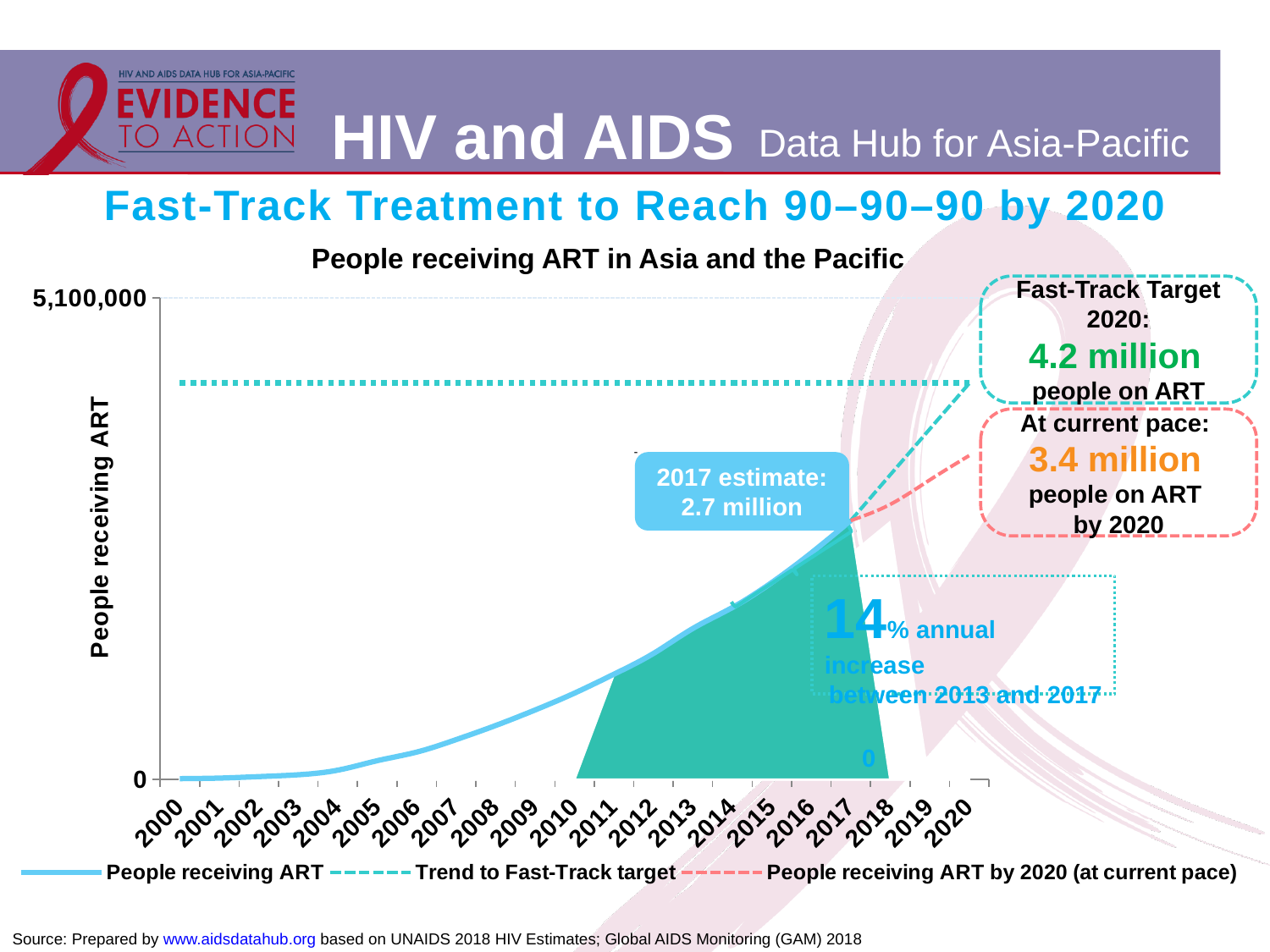
What is the difference between the Fast-Track Target for 2020 and the projected number on ART by 2020 at the current pace? 0.8 million What is the Fast-Track Target for 2020 for people on ART? 4.2 million What annual increase in people receiving ART is noted between 2013 and 2017? 14% What is the title of the chart? People receiving ART in Asia and the Pacific How many series does the legend list? 3 What kind of chart is used to show people receiving ART in Asia and the Pacific? Line chart Which is larger: the Fast-Track Target for 2020 or the projection at current pace for 2020? Fast-Track Target 2020 At the current pace, how many people are projected to be on ART by 2020? 3.4 million What is the 2017 estimate of people receiving ART shown on the chart? 2.7 million Does the number of people receiving ART rise or fall from 2000 to 2017? Rise What is the highest value labelled on the y axis? 5,100,000 How many years are labelled on the x axis? 21